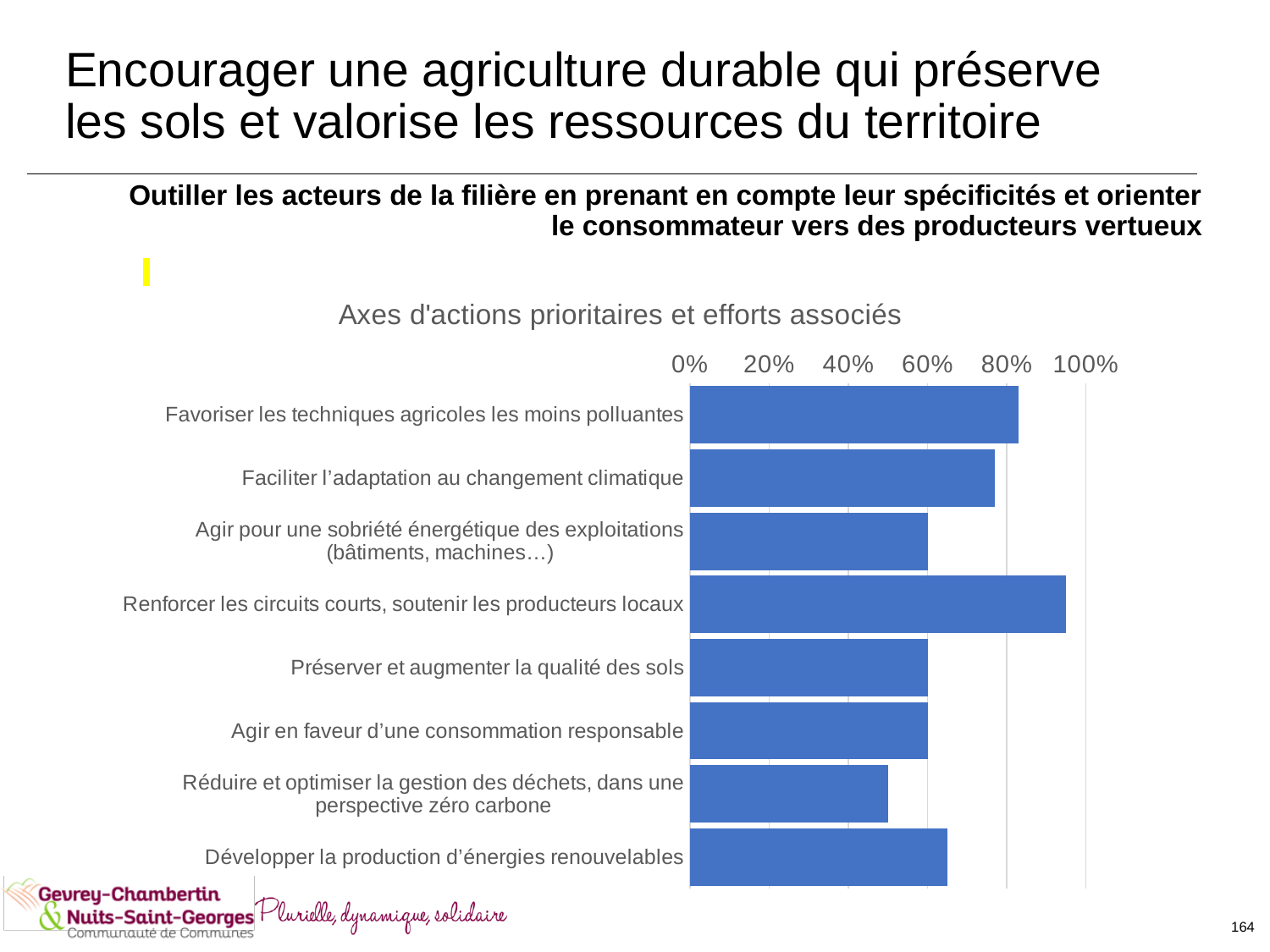
Is the value for "Faciliter l'adaptation au changement climatique" greater or less than 60%? greater Which has the larger value: "Favoriser les techniques agricoles les moins polluantes" or "Faciliter l'adaptation au changement climatique"? Favoriser les techniques agricoles les moins polluantes Is the value for "Renforcer les circuits courts, soutenir les producteurs locaux" greater or less than 80%? greater What is the title of the chart? Axes d'actions prioritaires et efforts associés What colour are the bars in the chart? Blue How many categories (action axes) are plotted in the chart? 8 What kind of chart is shown on the slide? Bar chart Which has the larger value: "Développer la production d'énergies renouvelables" or "Renforcer les circuits courts, soutenir les producteurs locaux"? Renforcer les circuits courts, soutenir les producteurs locaux Which category has the highest value in the chart? Renforcer les circuits courts, soutenir les producteurs locaux Is the value for "Réduire et optimiser la gestion des déchets, dans une perspective zéro carbone" greater or less than 60%? less Which category has the lowest value in the chart? Réduire et optimiser la gestion des déchets, dans une perspective zéro carbone